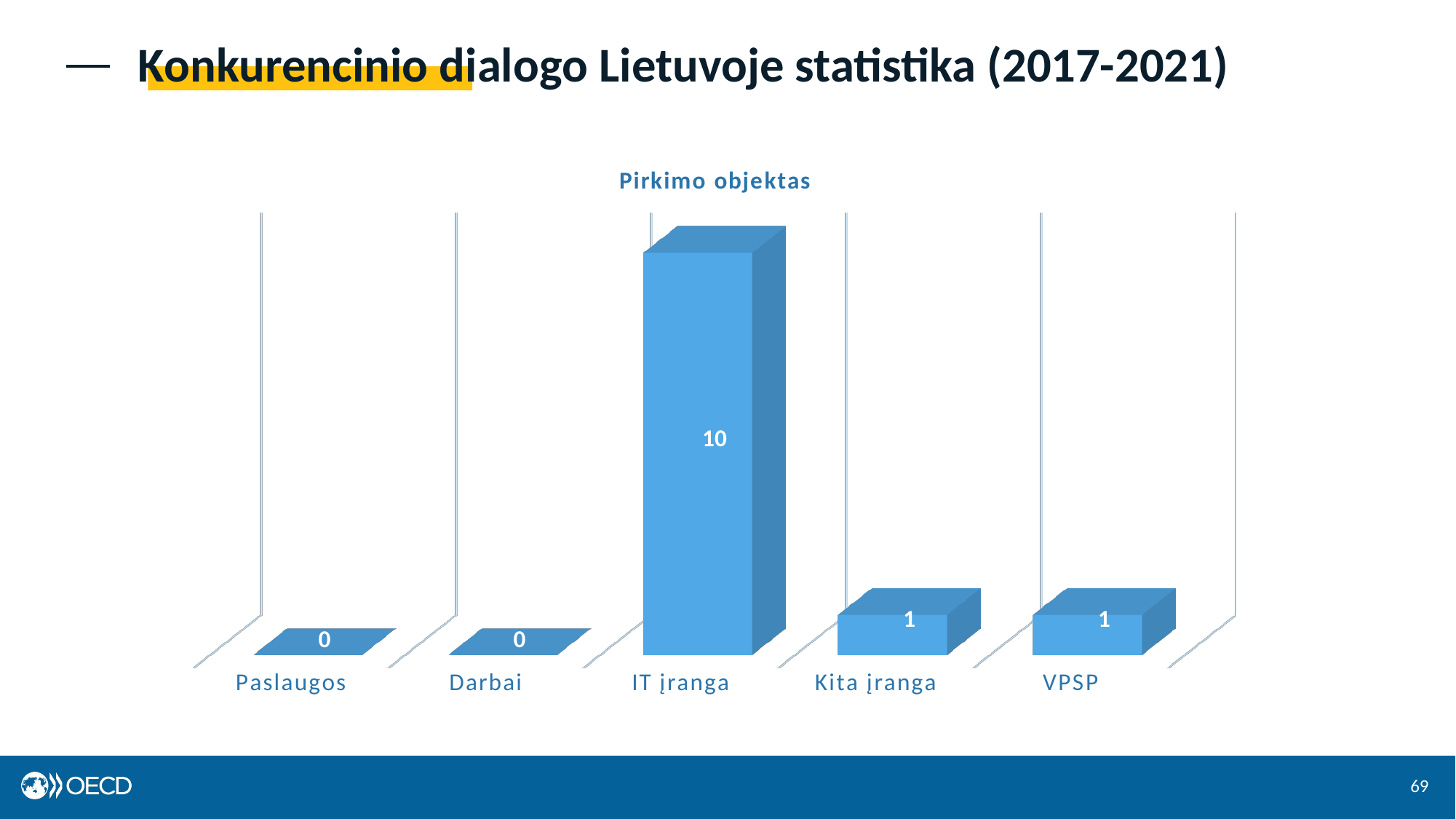
What is the title of the chart? Pirkimo objektas How many categories are shown on the x axis? 5 What is the value for Paslaugos? 0 What is the total of all the values shown in the chart? 12 What is the value for IT įranga? 10 What is the value for Kita įranga? 1 How many categories have a value of 0? 2 What is the value for VPSP? 1 What kind of chart is shown on the slide? Bar chart Which is larger, the value for IT įranga or the value for VPSP? IT įranga Which category has the highest value? IT įranga What is the difference between the values for IT įranga and Kita įranga? 9